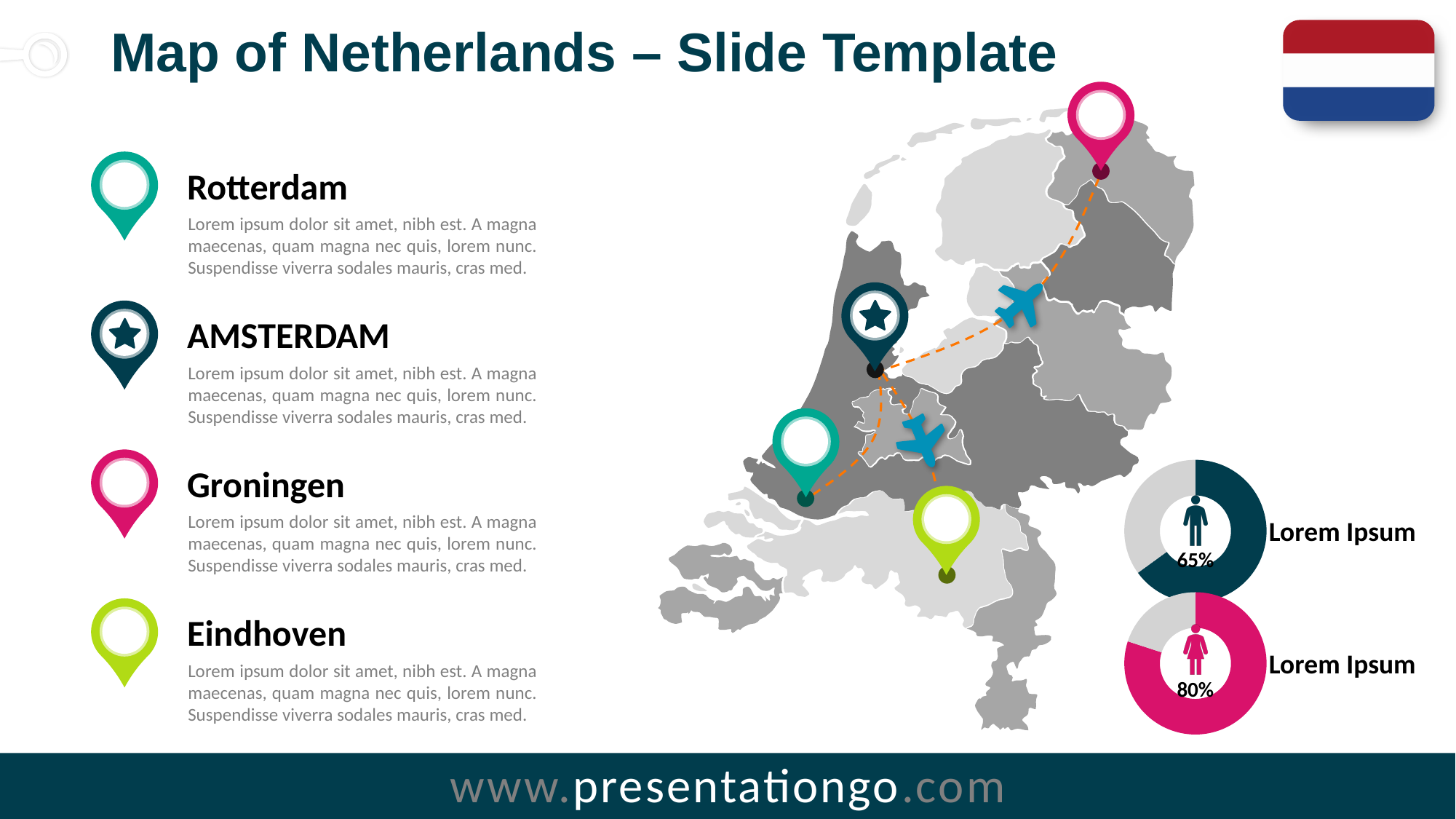
What kind of charts are shown on the right side of the slide next to the map? donut (pie) charts Which of the two donut charts on the right shows the larger percentage, the upper one (male icon) or the lower one (female icon)? the lower one (female icon) What value is shown on the lower donut chart with the female figure icon? 80% What colour is the filled portion of the upper donut chart with the male icon? dark teal What colour is the filled portion of the lower donut chart with the female icon? pink (magenta) Is the value shown on the upper donut chart (male icon) greater or less than 50%? greater What value is shown on the upper donut chart with the male figure icon? 65% Is the value shown on the lower donut chart (female icon) greater or less than 75%? greater What is the difference in percentage points between the lower donut chart (80%) and the upper donut chart (65%)? 15 percentage points What label text appears to the right of each donut chart? Lorem Ipsum How many donut charts are shown on the slide? 2